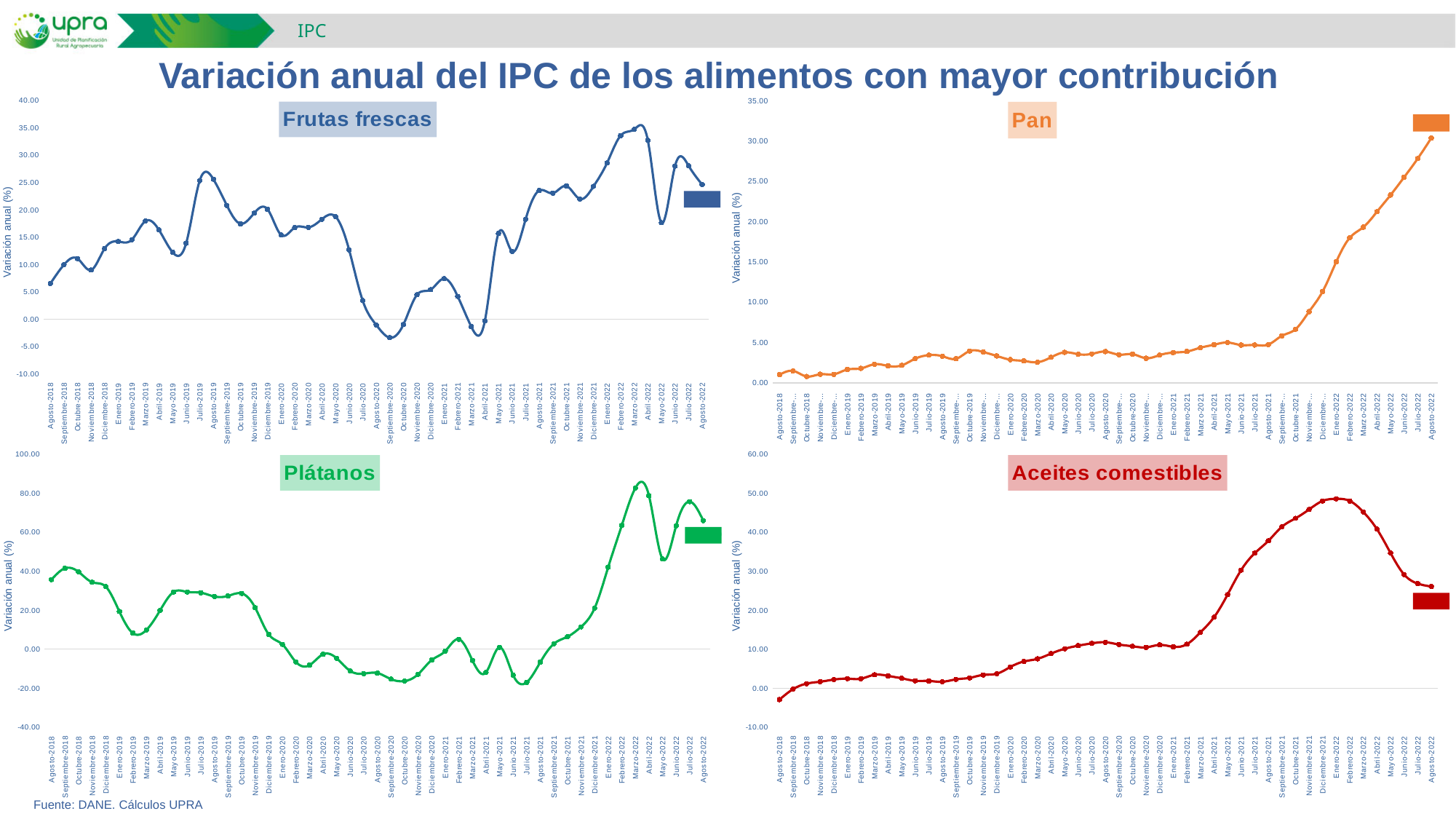
In the 'Pan' chart, which is larger: the value for Agosto-2018 or the value for Agosto-2022? Agosto-2022 How many charts are shown on the slide? 4 In the 'Plátanos' chart, is the value for Marzo-2022 greater or less than 60.00? greater In the 'Aceites comestibles' chart, which month has the lowest value? Agosto-2018 What kind of chart is the 'Frutas frescas' chart? Line chart In the 'Pan' chart, is the value for Agosto-2022 greater or less than 25.00? greater In the 'Pan' chart, do the values rise or fall from Agosto-2021 to Agosto-2022? rise What is the title of the slide? Variación anual del IPC de los alimentos con mayor contribución In the 'Aceites comestibles' chart, is the value for Agosto-2022 greater or less than 20.00? greater In the 'Pan' chart, which month has the highest value? Agosto-2022 In the 'Aceites comestibles' chart, do the values rise or fall from Febrero-2022 to Agosto-2022? fall